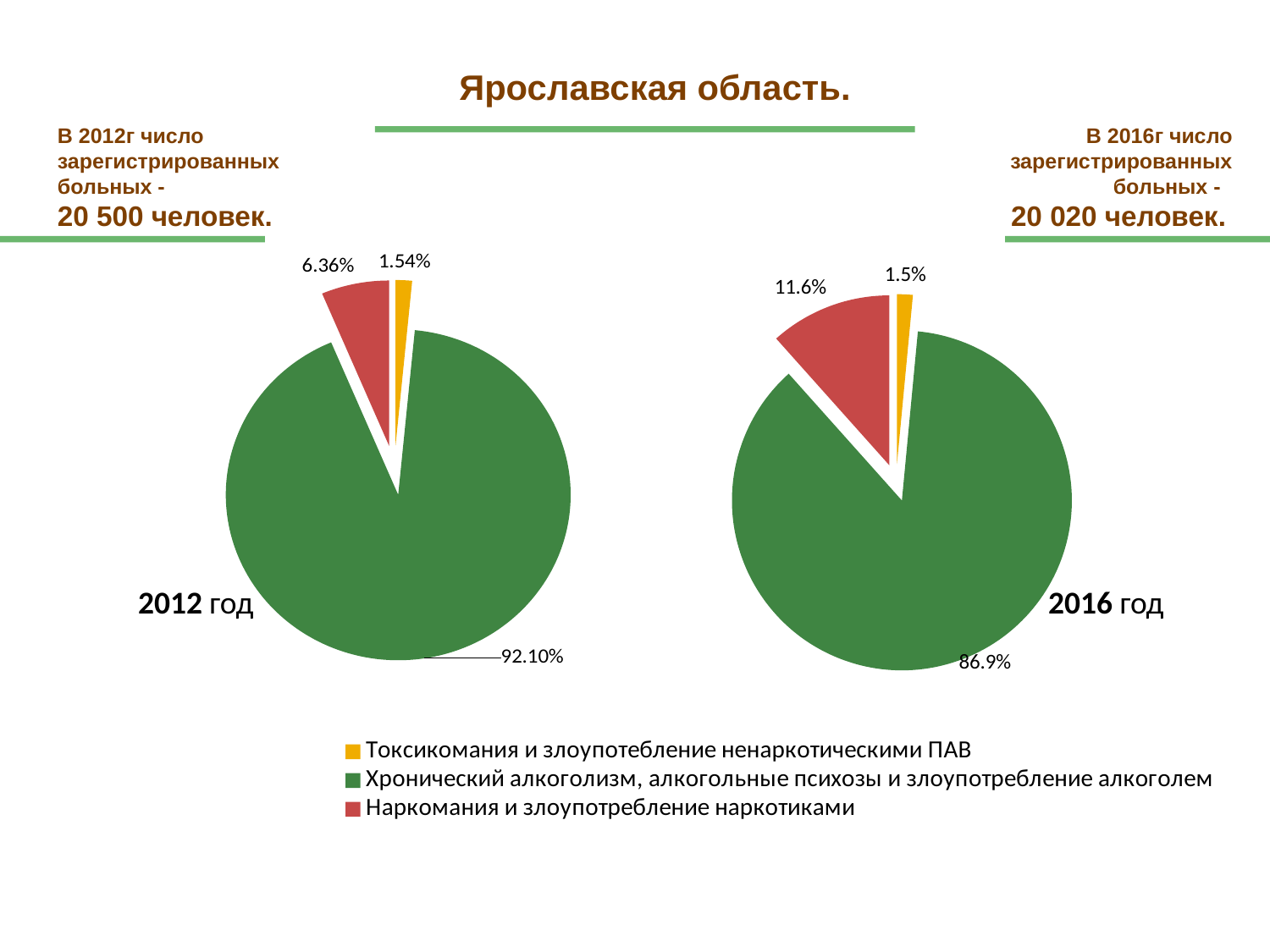
What type of chart is used for the 2016 data? Pie chart What is the difference between the share of Наркомания и злоупотребление наркотиками in the 2016 pie chart and in the 2012 pie chart? 5.24% Which is larger: the share of Наркомания и злоупотребление наркотиками in the 2012 pie chart or in the 2016 pie chart? 2016 In the 2016 pie chart, which category has the smallest share? Токсикомания и злоупотебление ненаркотическими ПАВ How many slices does the 2012 pie chart have? 3 How many entries does the legend list? 3 In the 2012 pie chart, which category has the largest share? Хронический алкоголизм, алкогольные психозы и злоупотребление алкоголем In the 2016 pie chart, what share is shown for Наркомания и злоупотребление наркотиками? 11.6% In the 2012 pie chart, what share is shown for Хронический алкоголизм, алкогольные психозы и злоупотребление алкоголем? 92.10% In the 2016 pie chart, what share is shown for Хронический алкоголизм, алкогольные психозы и злоупотребление алкоголем? 86.9% In the 2012 pie chart, what share is shown for Токсикомания и злоупотебление ненаркотическими ПАВ? 1.54% What colour represents Наркомания и злоупотребление наркотиками in the legend? Red